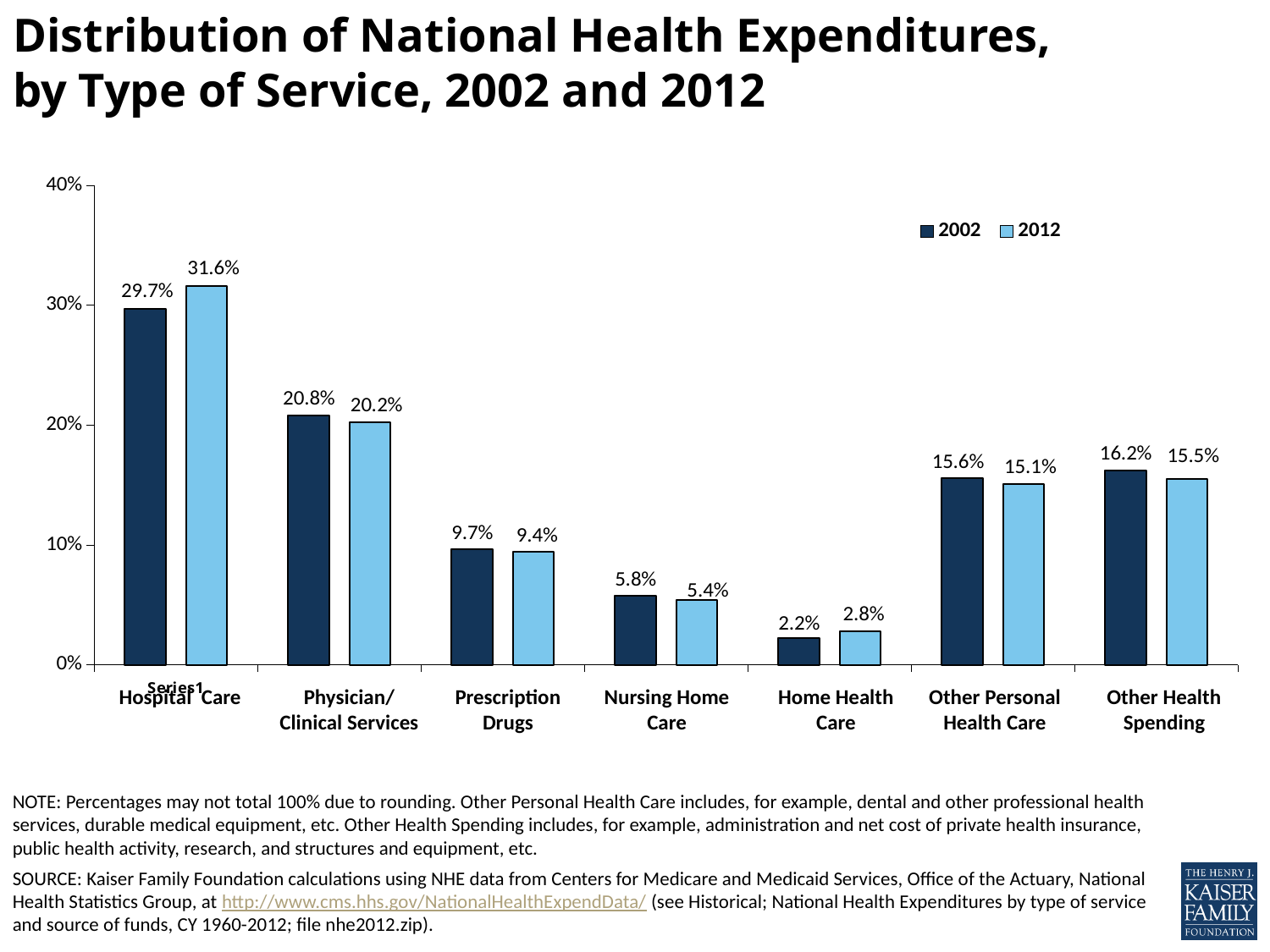
Was the share for Other Health Spending higher in 2002 or in 2012? 2002 How many types of service are shown on the x axis? 7 Which type of service had the lowest share of expenditures in 2012? Home Health Care What was the share for Prescription Drugs in 2002? 9.7% Is the 2012 value for Other Personal Health Care greater or less than 20%? less What was the share of national health expenditures for Hospital Care in 2012? 31.6% What kind of chart is shown on the slide? Bar chart How many series does the legend list? 2 What was the share for Home Health Care in 2012? 2.8% Which type of service had the highest share of expenditures in 2002? Hospital Care What is the difference between the 2002 and 2012 shares for Physician/Clinical Services? 0.6 percentage points By how many percentage points did the Hospital Care share change from 2002 to 2012? 1.9 percentage points